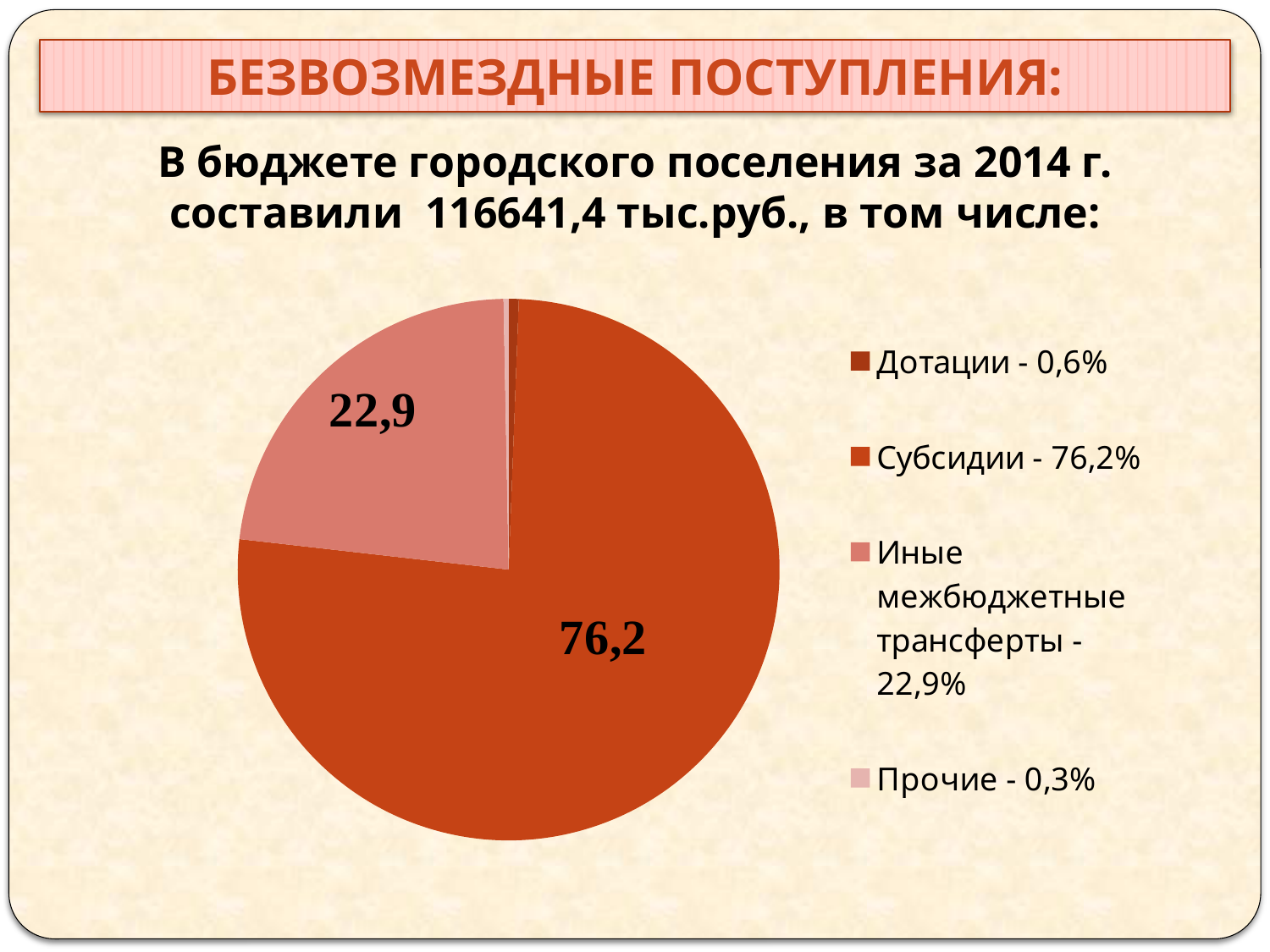
Which category has the smallest slice of the pie? Прочие What share of the pie does Субсидии account for? 76,2% Which category has the largest slice of the pie? Субсидии How many categories does the legend of the pie chart list? 4 What kind of chart is shown on the slide? pie chart What share of the pie does Иные межбюджетные трансферты account for? 22,9% What is the value shown for Прочие in the legend? 0,3% Which is larger, the share for Субсидии or the share for Иные межбюджетные трансферты? Субсидии What is the difference in percentage points between the Субсидии share and the Иные межбюджетные трансферты share? 53,3 What is the value shown for Дотации in the legend? 0,6% What total amount in thousand rubles does the slide text give for безвозмездные поступления in 2014? 116641,4 тыс.руб. What is the difference in percentage points between the Дотации share and the Прочие share? 0,3